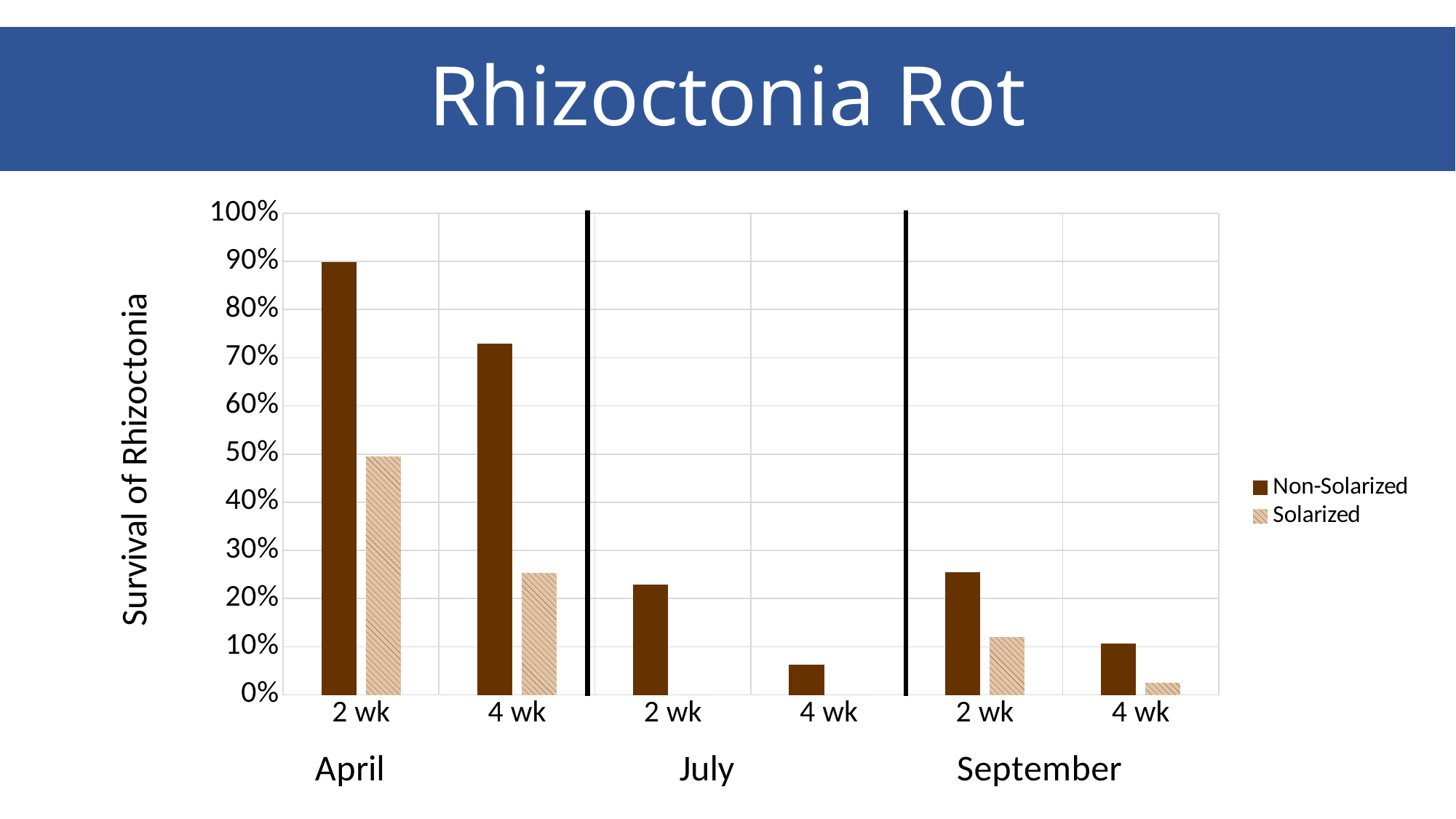
Does the Non-Solarized value rise or fall from 2 wk to 4 wk in April? fall Which bar is the highest in the chart? Non-Solarized, April 2 wk Is the Non-Solarized value for July 2 wk greater or less than 30%? less What are the two series named in the legend? Non-Solarized and Solarized What is the title of the vertical axis? Survival of Rhizoctonia For September 2 wk, which is larger: the Non-Solarized or the Solarized value? Non-Solarized Is the Non-Solarized value for July 4 wk greater or less than 10%? less Is the Non-Solarized value for April 4 wk greater or less than 60%? greater How many series does the legend list? 2 What kind of chart is shown on the slide? bar chart How many months are shown along the x axis? 3